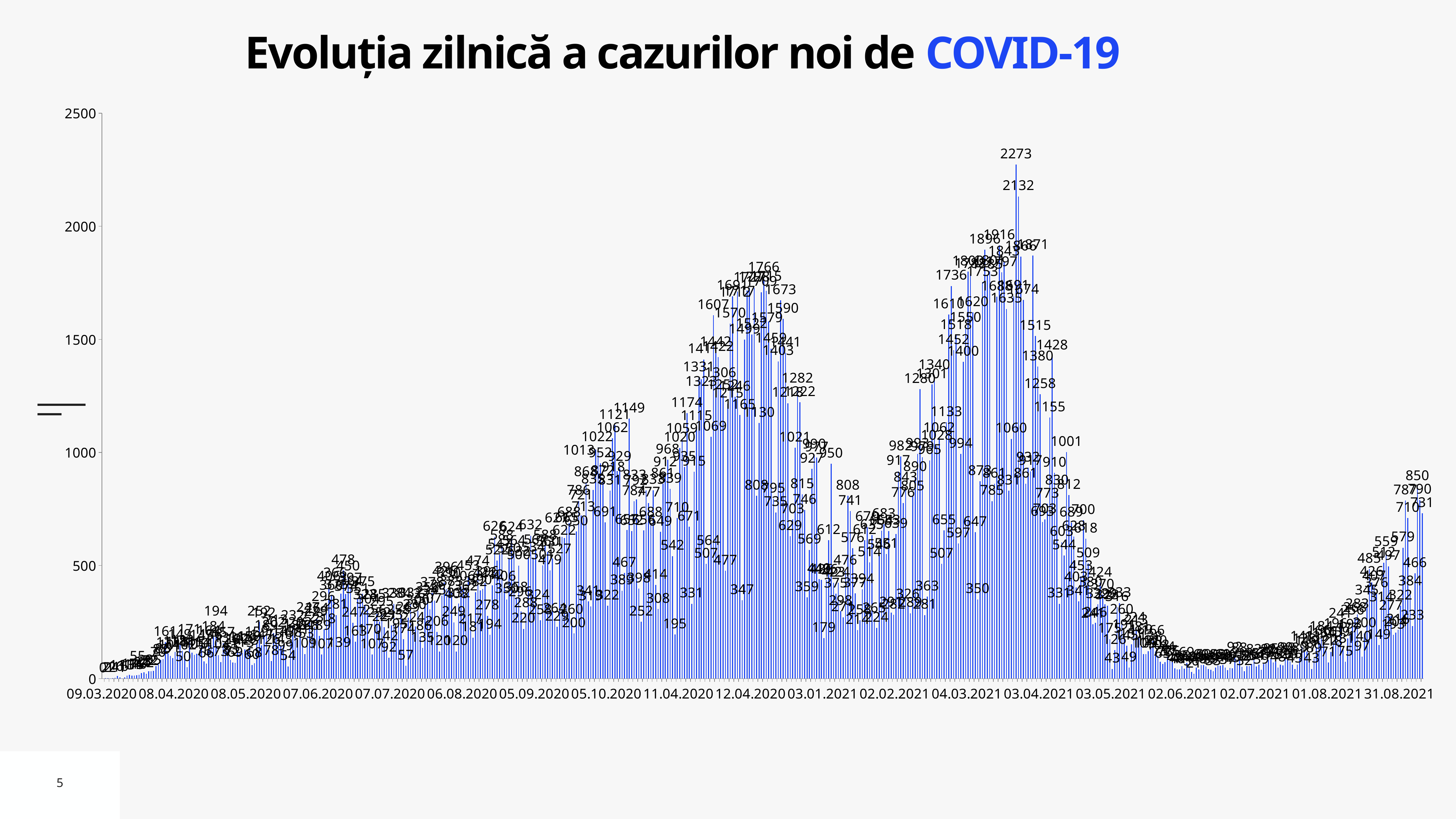
Do the values rise or fall between 02.06.2021 and 31.08.2021? rise What is the title of the chart? Evoluția zilnică a cazurilor noi de COVID-19 Do the values rise or fall between 03.04.2021 and 02.06.2021? fall What is the highest tick value shown on the vertical axis? 2500 What is the second-highest daily value labelled on the chart, next to the 2273 peak? 2132 Is the value at 09.03.2020 greater or less than 500? less What kind of chart is shown on the slide? bar chart What is the highest daily value labelled on the chart? 2273 What is the first date label on the horizontal axis? 09.03.2020 Is the peak value around 03.04.2021 greater or less than the peak value around 12.04.2020? greater What is the last date label on the horizontal axis? 31.08.2021 Is the highest value on the chart greater or less than 2000? greater